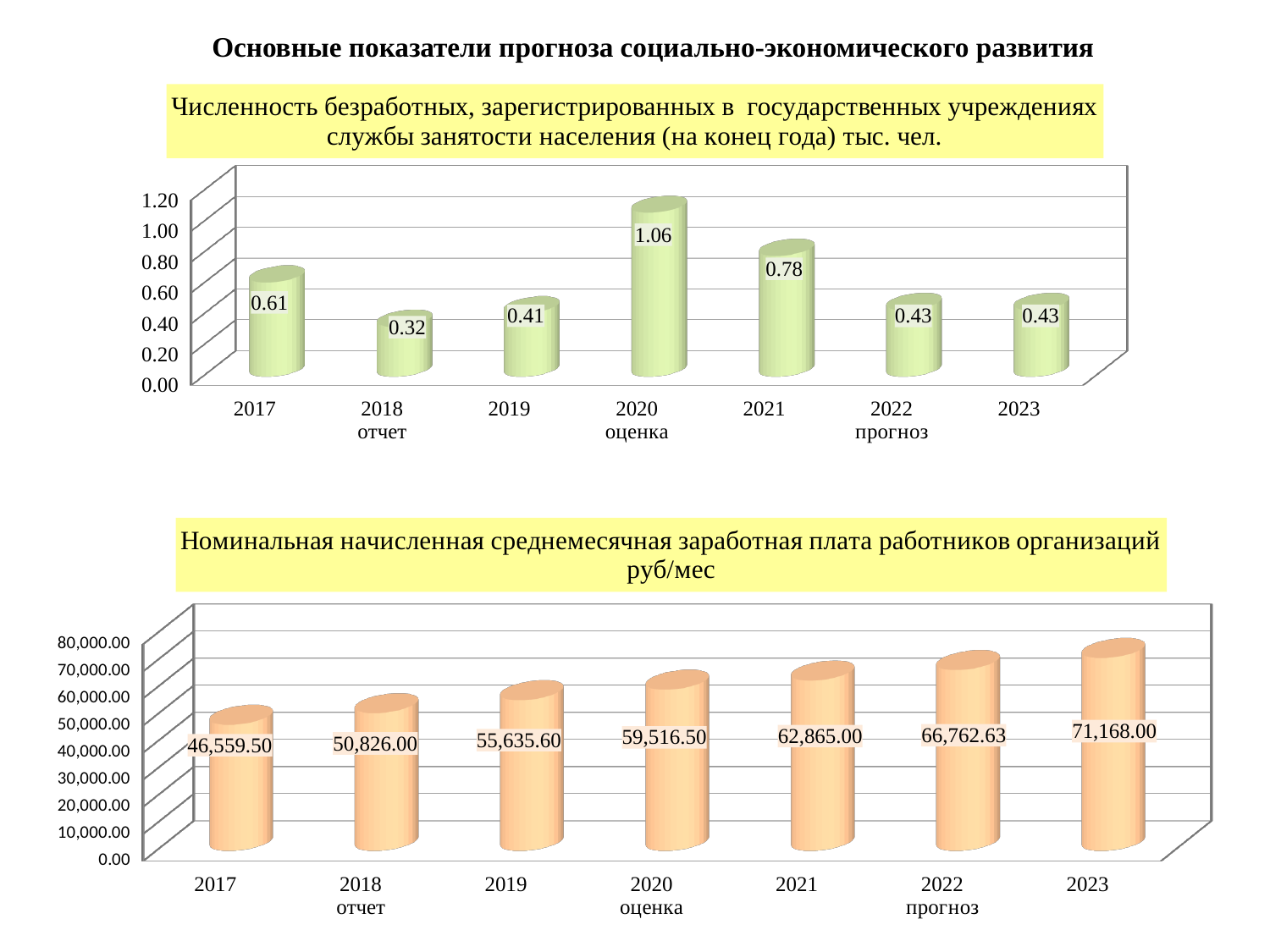
In the top chart (number of registered unemployed), which year has the highest value? 2020 What type of chart is the bottom chart (nominal average monthly wage)? bar chart In the top chart (number of registered unemployed), which year has the lowest value? 2018 In the top chart (number of registered unemployed), what is the difference between the 2020 and 2021 values? 0.28 In the bottom chart (nominal average monthly wage), which is larger: the value for 2018 or the value for 2020? 2020 In the top chart (number of registered unemployed), how many years are plotted? 7 In the bottom chart (nominal average monthly wage), what is the difference between the 2023 and 2022 values? 4,405.37 In the bottom chart (nominal average monthly wage), do the values rise or fall from 2017 to 2023? rise In the bottom chart (nominal average monthly wage), what is the value for 2019? 55,635.60 In the top chart (number of registered unemployed), what is the value for 2020? 1.06 In the bottom chart (nominal average monthly wage), what is the value for 2023? 71,168.00 In the top chart (number of registered unemployed), is the value for 2017 greater or less than 0.60? greater